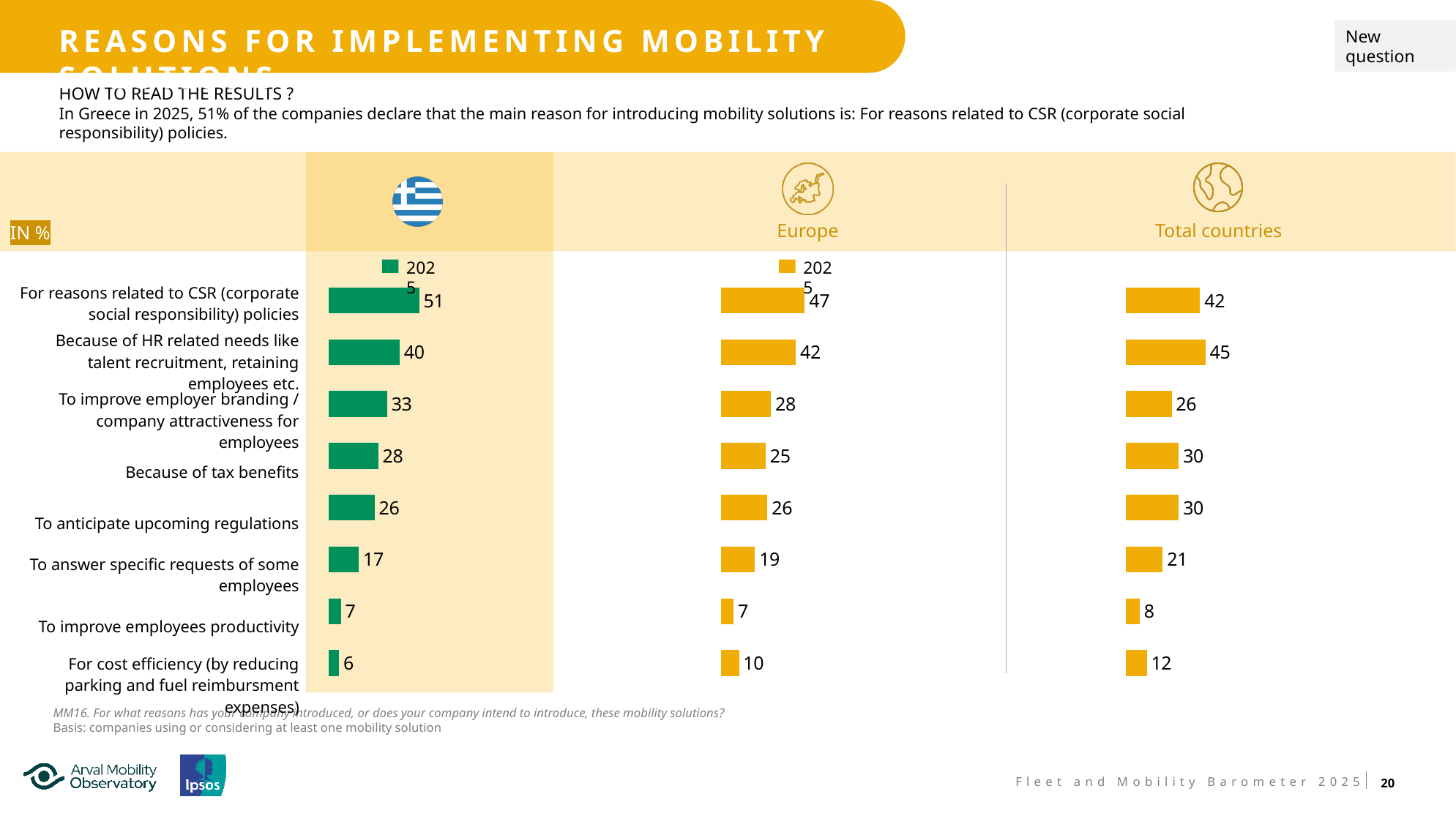
What kind of chart is used for the Europe data? Bar chart In the Greece chart, which reason has the highest value? For reasons related to CSR (corporate social responsibility) policies In the Europe chart, what is the value for 'To anticipate upcoming regulations'? 26 For 'To improve employer branding / company attractiveness for employees', which is larger: the Greece value or the Total countries value? Greece In the Total countries chart, which reason has the lowest value? To improve employees productivity How many reasons (categories) are listed in the Greece chart? 8 In the Total countries chart, what is the value for 'Because of HR related needs like talent recruitment, retaining employees etc.'? 45 In the Greece chart, what is the value for 'Because of tax benefits'? 28 What is the difference between the Greece value and the Europe value for 'For reasons related to CSR (corporate social responsibility) policies'? 4 In the Total countries chart, what is the difference between 'For reasons related to CSR (corporate social responsibility) policies' and 'For cost efficiency (by reducing parking and fuel reimbursment expenses)'? 30 Which year does the legend of the Greece chart show? 2025 In the Europe chart, which reason has the lowest value? To improve employees productivity